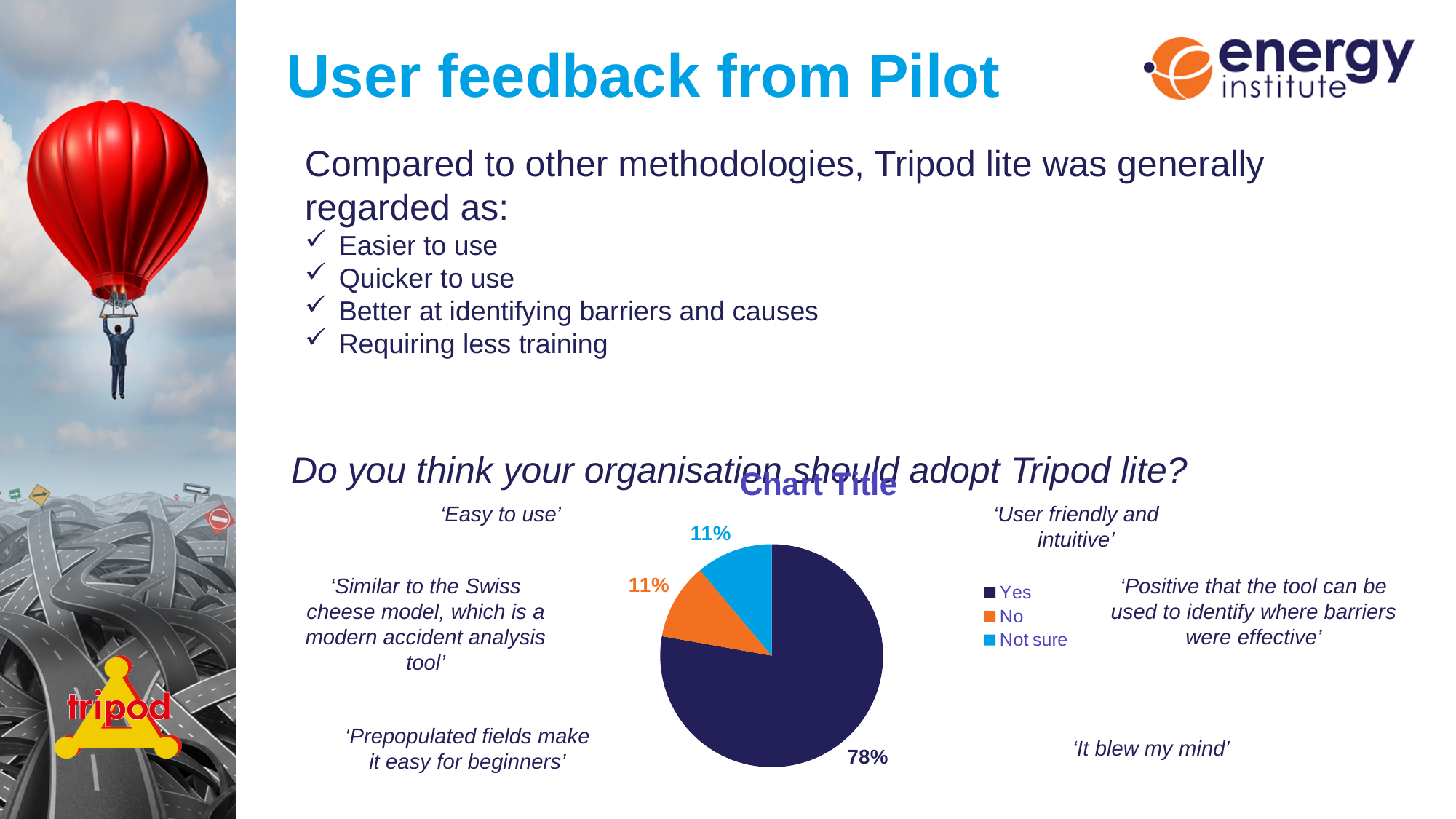
What percentage of respondents answered No? 11% What kind of chart is shown on the slide? pie chart Which is larger, the Yes slice or the Not sure slice? Yes What percentage of respondents answered Not sure? 11% What percentage of respondents answered Yes? 78% What is the combined share of the No and Not sure slices? 22% What is the difference in percentage points between the Yes and No slices? 67 How many entries does the legend list? 3 Which response has the largest share of the pie? Yes How many slices does the pie chart have? 3 What title is printed above the pie chart? Chart Title What colour is the Yes slice in the pie chart? dark navy blue